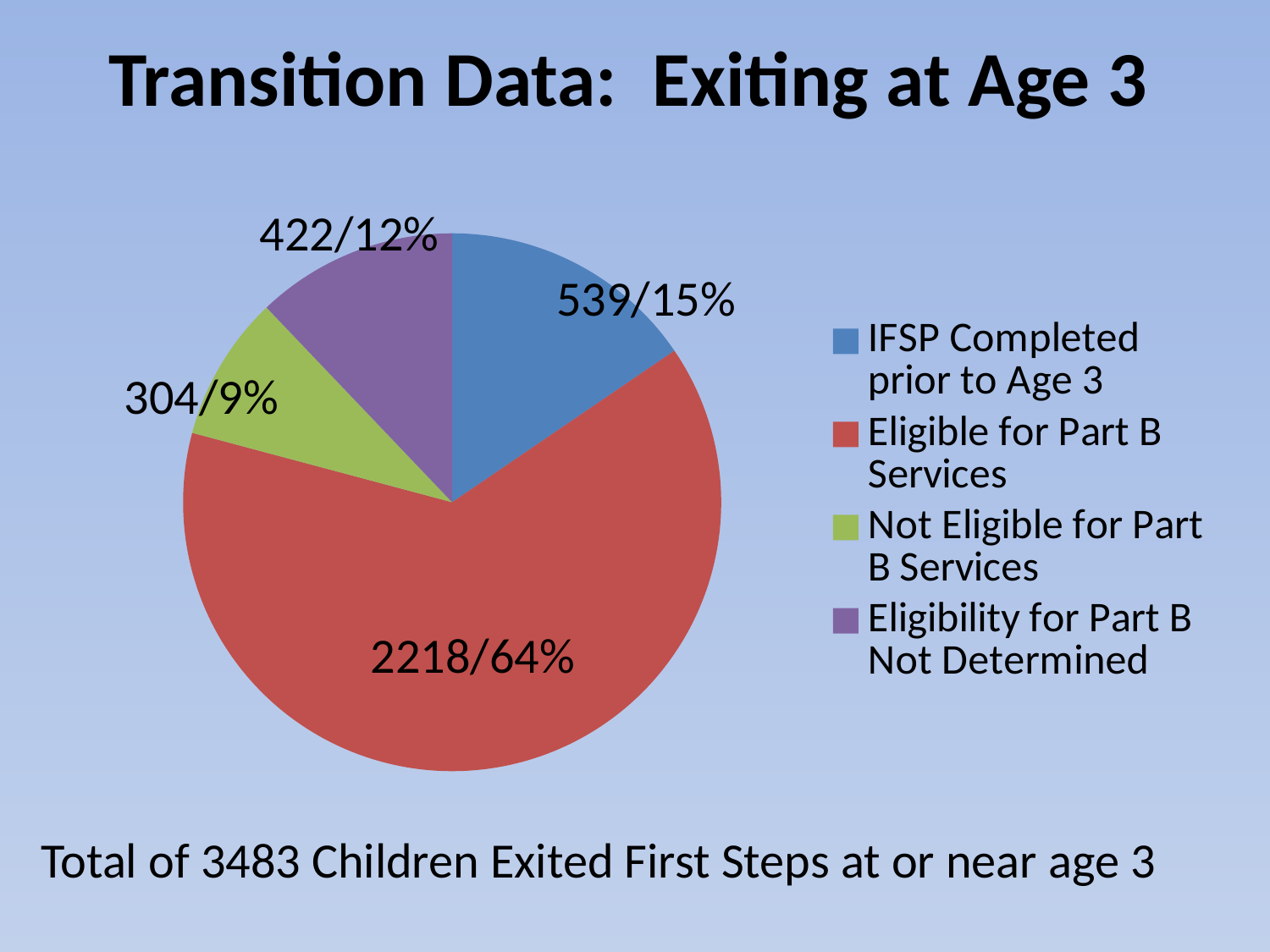
Which category has the largest slice of the pie? Eligible for Part B Services What is the data label for the 'Eligible for Part B Services' slice? 2218/64% How many categories does the pie chart show? 4 What is the difference in count between 'Eligible for Part B Services' and 'IFSP Completed prior to Age 3'? 1679 What share of the pie does the 'Eligibility for Part B Not Determined' slice represent? 12% What kind of chart is shown on the slide? pie chart What is the data label for the 'IFSP Completed prior to Age 3' slice? 539/15% What is the data label for the 'Not Eligible for Part B Services' slice? 304/9% What is the data label for the 'Eligibility for Part B Not Determined' slice? 422/12% Which category has the smallest slice of the pie? Not Eligible for Part B Services What colour is the 'Not Eligible for Part B Services' slice? green Which is larger: the count for 'IFSP Completed prior to Age 3' or for 'Eligibility for Part B Not Determined'? IFSP Completed prior to Age 3